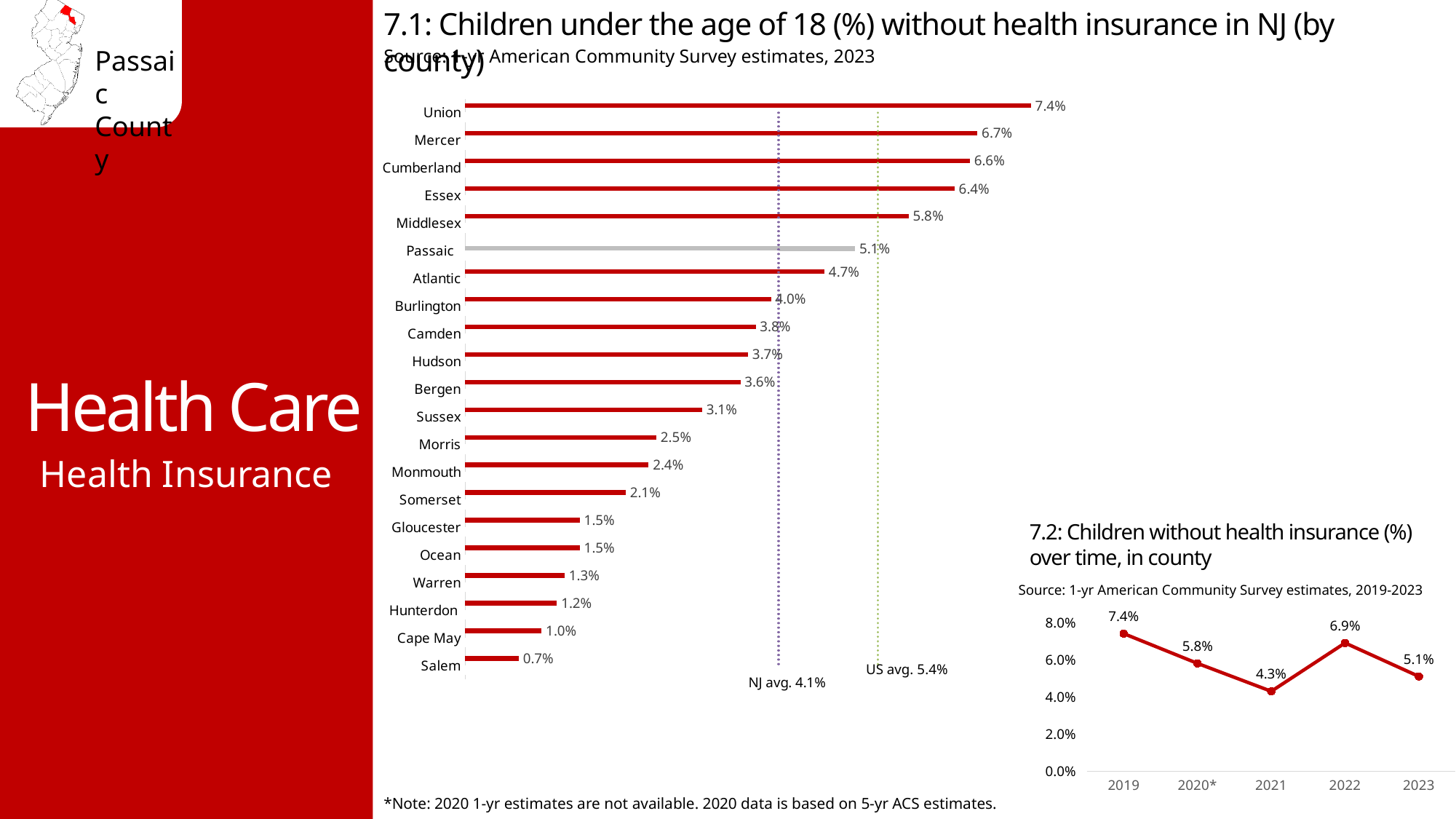
In chart 7.2, what is the difference between the values for 2019 and 2023? 2.3% What kind of chart is chart 7.1? bar chart In chart 7.1, how many counties are shown? 21 In chart 7.1, which is larger, the value for Essex or the value for Middlesex? Essex In chart 7.1, which county has the lowest percentage of children without health insurance? Salem In chart 7.1, what is the NJ average shown by the dotted line? 4.1% In chart 7.1, what is the difference between the values for Union and Passaic? 2.3% In chart 7.1, what is the value for Passaic? 5.1% What kind of chart is chart 7.2? line chart In chart 7.2, what is the value for 2022? 6.9% In chart 7.2, which year has the lowest value? 2021 In chart 7.1, which county has the highest percentage of children without health insurance? Union